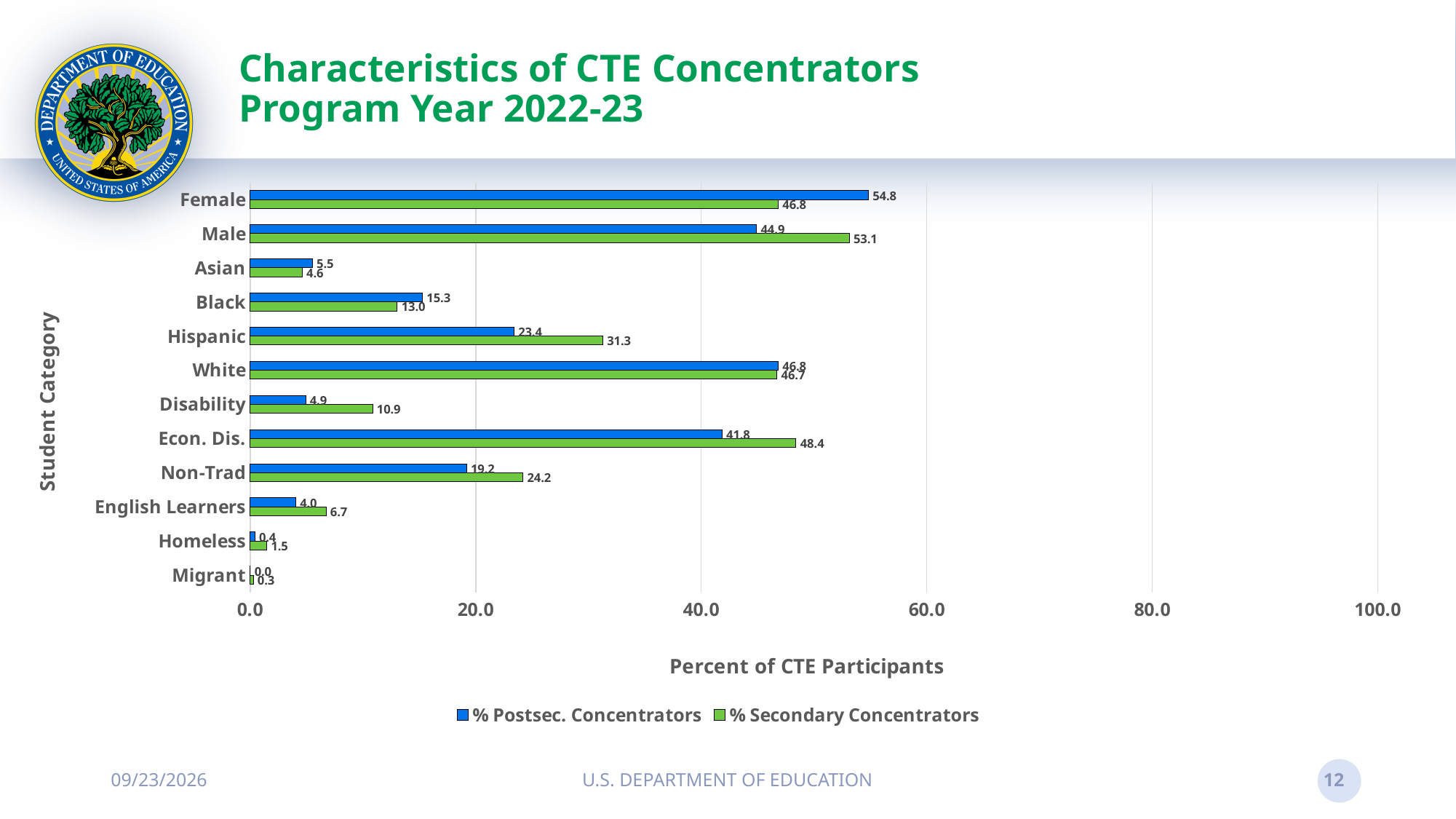
What is the % Secondary Concentrators value for Hispanic? 31.3 What is the difference between the % Secondary Concentrators and % Postsec. Concentrators values for Econ. Dis.? 6.6 What is the label of the horizontal axis? Percent of CTE Participants For Male, which is larger: % Postsec. Concentrators or % Secondary Concentrators? % Secondary Concentrators What is the % Postsec. Concentrators value for Female? 54.8 How many series does the legend list? 2 How many student categories are shown on the chart? 12 Which student category has the lowest % Secondary Concentrators value? Migrant Is the % Secondary Concentrators value for Non-Trad greater or less than 20.0? greater Which student category has the highest % Postsec. Concentrators value? Female What kind of chart is shown on the slide? Bar chart What is the % Postsec. Concentrators value for Disability? 4.9